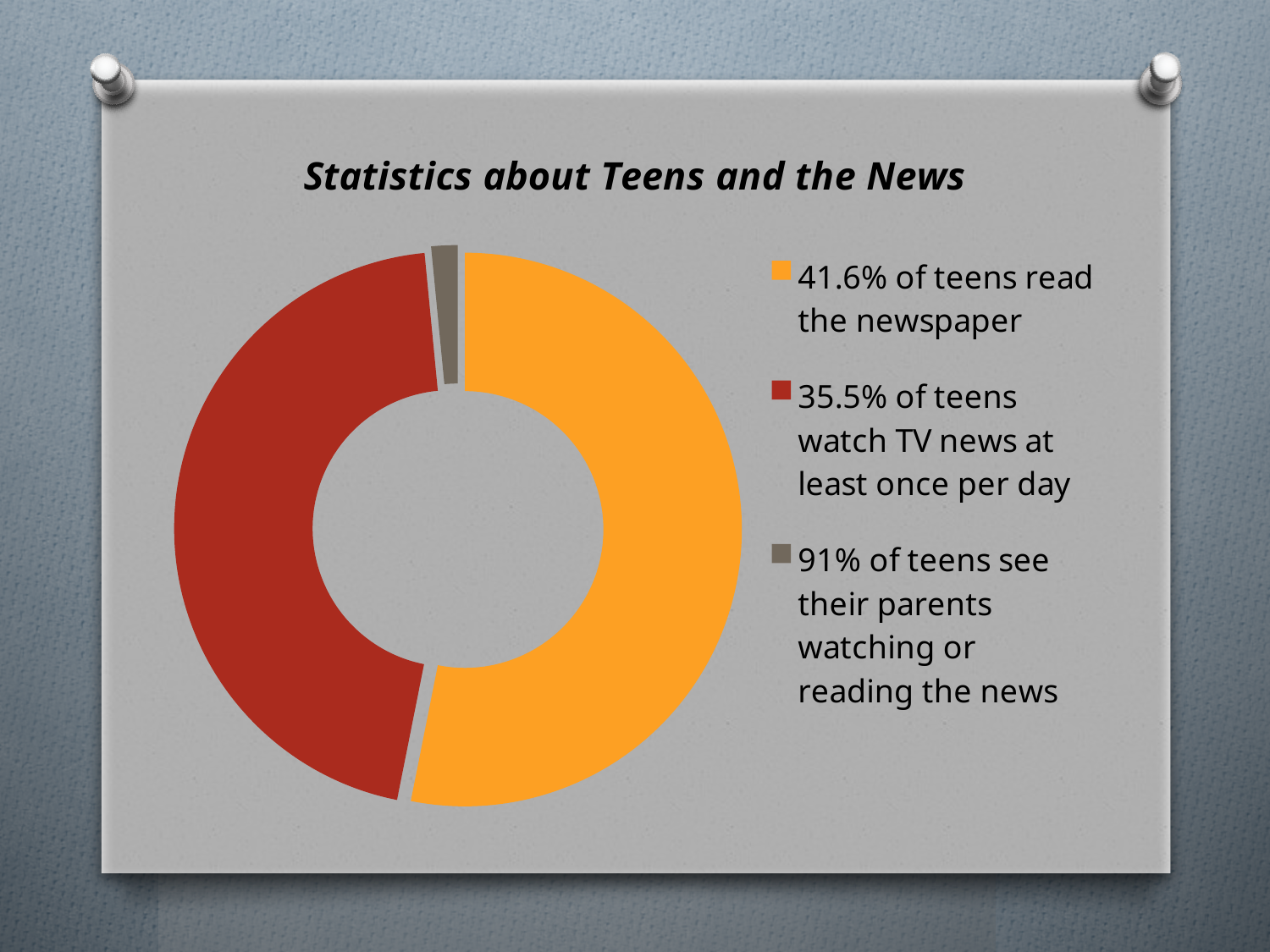
What is the title of the chart? Statistics about Teens and the News What kind of chart is shown on the slide? Doughnut (pie) chart What colour is the slice representing teens who watch TV news at least once per day? Red How many slices does the chart have? 3 Which is larger: the percentage of teens who see their parents watching or reading the news or the percentage who read the newspaper? Teens who see their parents watching or reading the news According to the legend, which statistic has the highest percentage? 91% of teens see their parents watching or reading the news Which is larger: the percentage of teens who read the newspaper or the percentage who watch TV news at least once per day? Teens who read the newspaper What percentage of teens watch TV news at least once per day? 35.5% What is the difference between the percentage of teens who read the newspaper and the percentage who watch TV news at least once per day? 6.1% According to the legend, which statistic has the lowest percentage? 35.5% of teens watch TV news at least once per day According to the legend, what percentage of teens read the newspaper? 41.6% What percentage of teens see their parents watching or reading the news? 91%